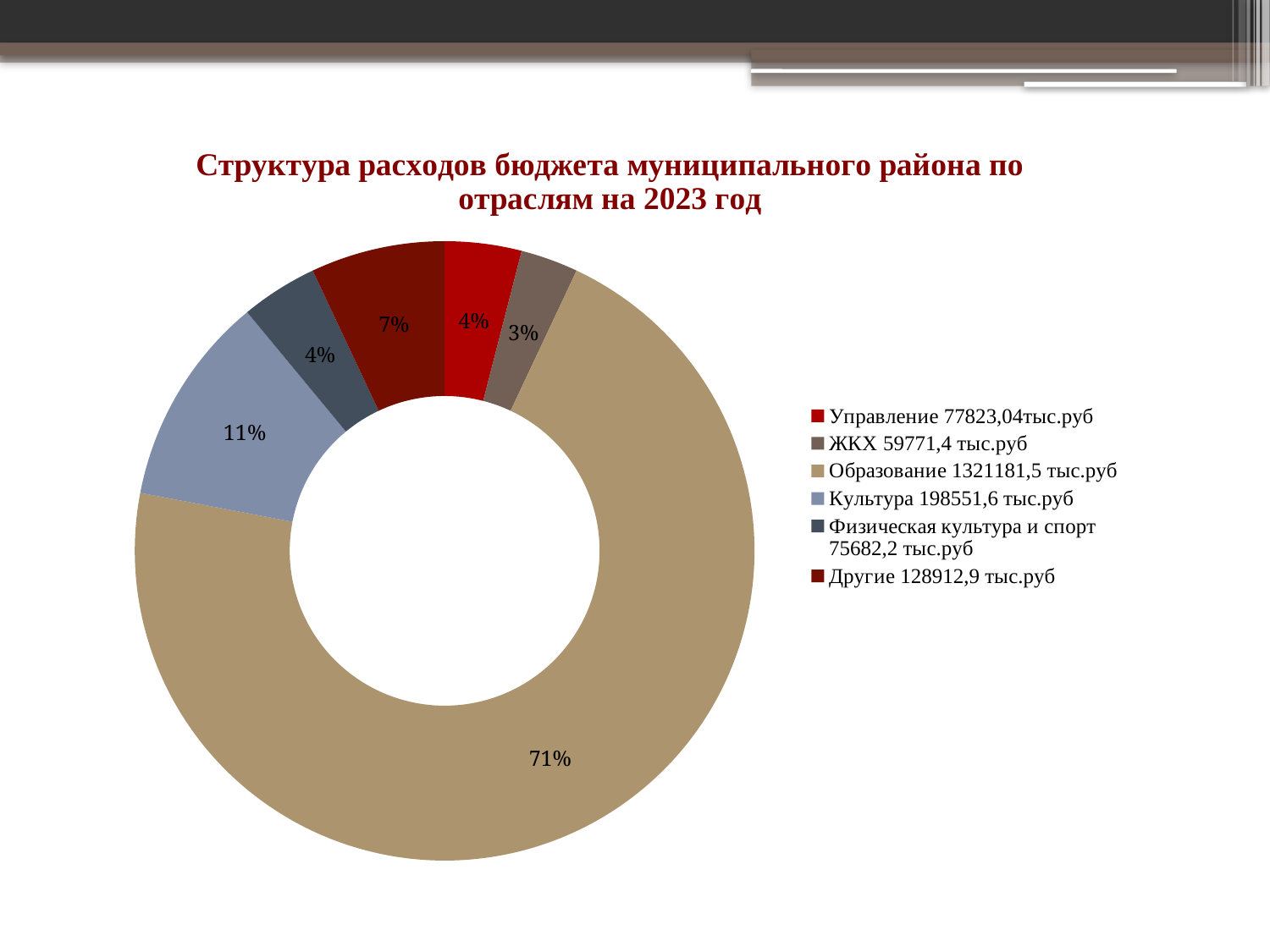
What share of the budget expenditure does Культура account for? 11% What is the title of the chart? Структура расходов бюджета муниципального района по отраслям на 2023 год How many categories are shown in the chart? 6 What share of the budget expenditure does Образование account for? 71% What amount is listed in the legend for Образование? 1321181,5 тыс.руб What share of the budget expenditure does Другие account for? 7% By how many percentage points does the share of Образование exceed the share of Культура? 60 percentage points Which category has the smallest share of the budget expenditure? ЖКХ Which category has the largest share of the budget expenditure? Образование What kind of chart is shown on the slide? doughnut (pie) chart Which has a larger share: Культура or Другие? Культура